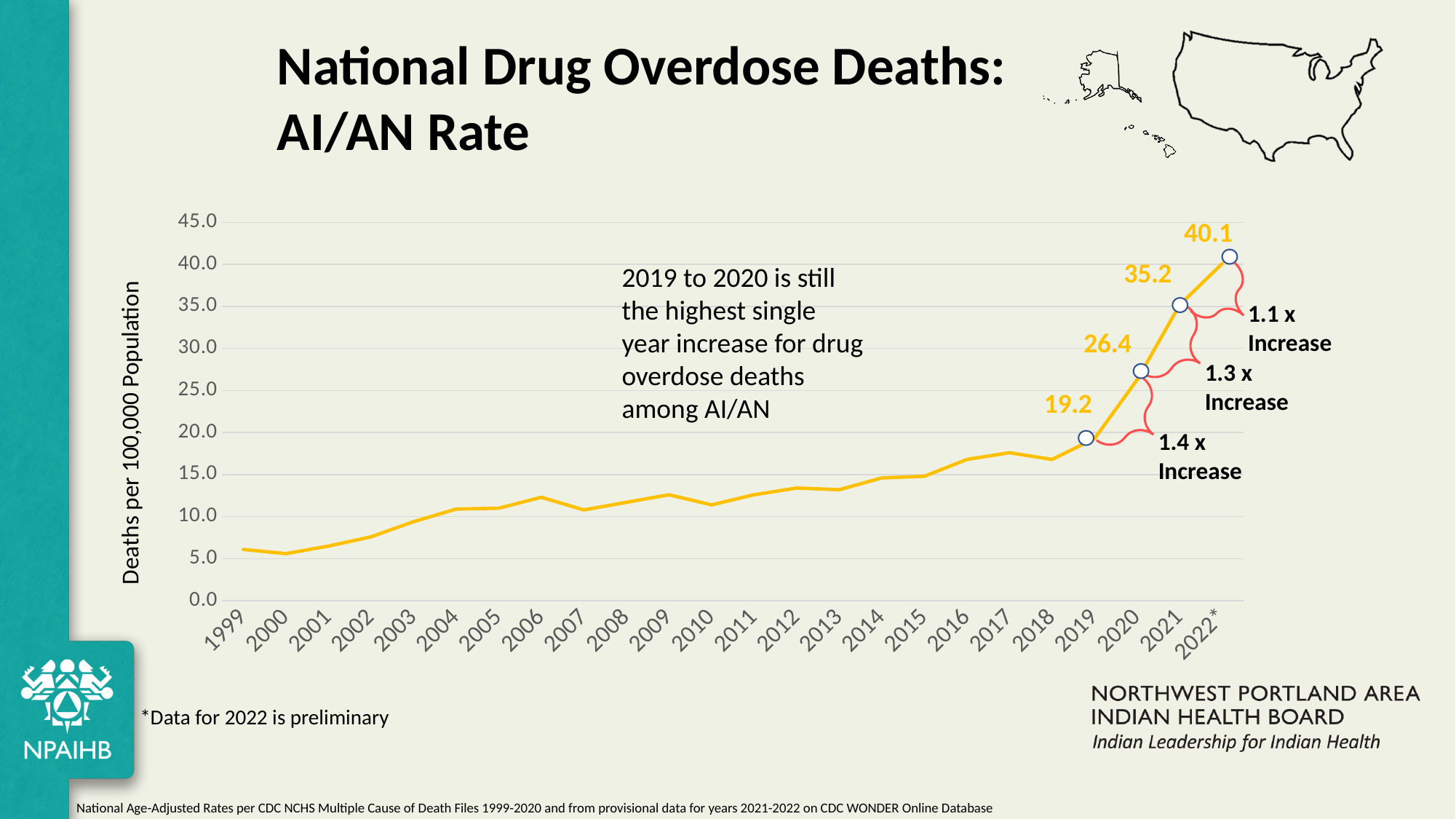
What is the AI/AN drug overdose death rate for 2019? 19.2 What is the value plotted for 2020? 26.4 What is the difference between the 2022* value and the 2021 value? 4.9 How many years are shown on the x axis of the chart? 24 Which year has the lowest drug overdose death rate on the chart? 2000 Which year has the highest drug overdose death rate on the chart? 2022* Is the value for 2010 greater or less than 15.0? less What is the value plotted for 2021? 35.2 What is the value plotted for 2022*? 40.1 What kind of chart is shown on the slide? line chart By how much did the rate increase from 2019 to 2020? 7.2 Is the value for 2017 greater or less than 15.0? greater